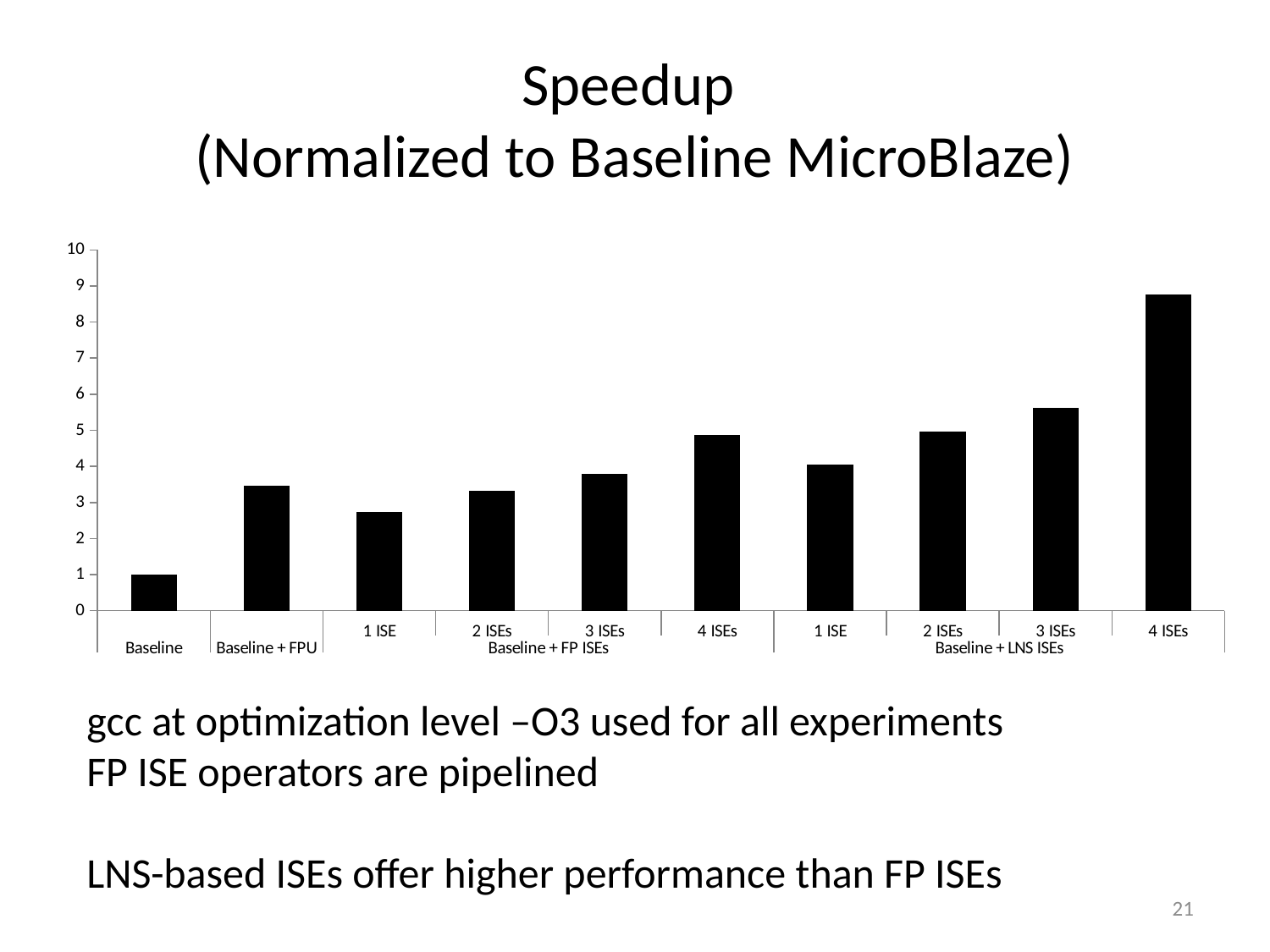
What type of chart is shown on the slide? bar chart Which category has the lowest speedup? Baseline Is the speedup for 3 ISEs under Baseline + LNS ISEs greater or less than 5? greater Which is larger: the speedup for 4 ISEs under Baseline + FP ISEs or 1 ISE under Baseline + LNS ISEs? 4 ISEs under Baseline + FP ISEs What is the speedup value for Baseline? 1 Is the speedup for 1 ISE under Baseline + FP ISEs greater or less than 3? less Within the Baseline + FP ISEs group, does the speedup rise or fall as the number of ISEs increases from 1 to 4? rise Is the speedup for Baseline + FPU greater or less than 3? greater Which category has the highest speedup? 4 ISEs (Baseline + LNS ISEs) How many bars are plotted in the chart? 10 What is the title of the chart? Speedup (Normalized to Baseline MicroBlaze)